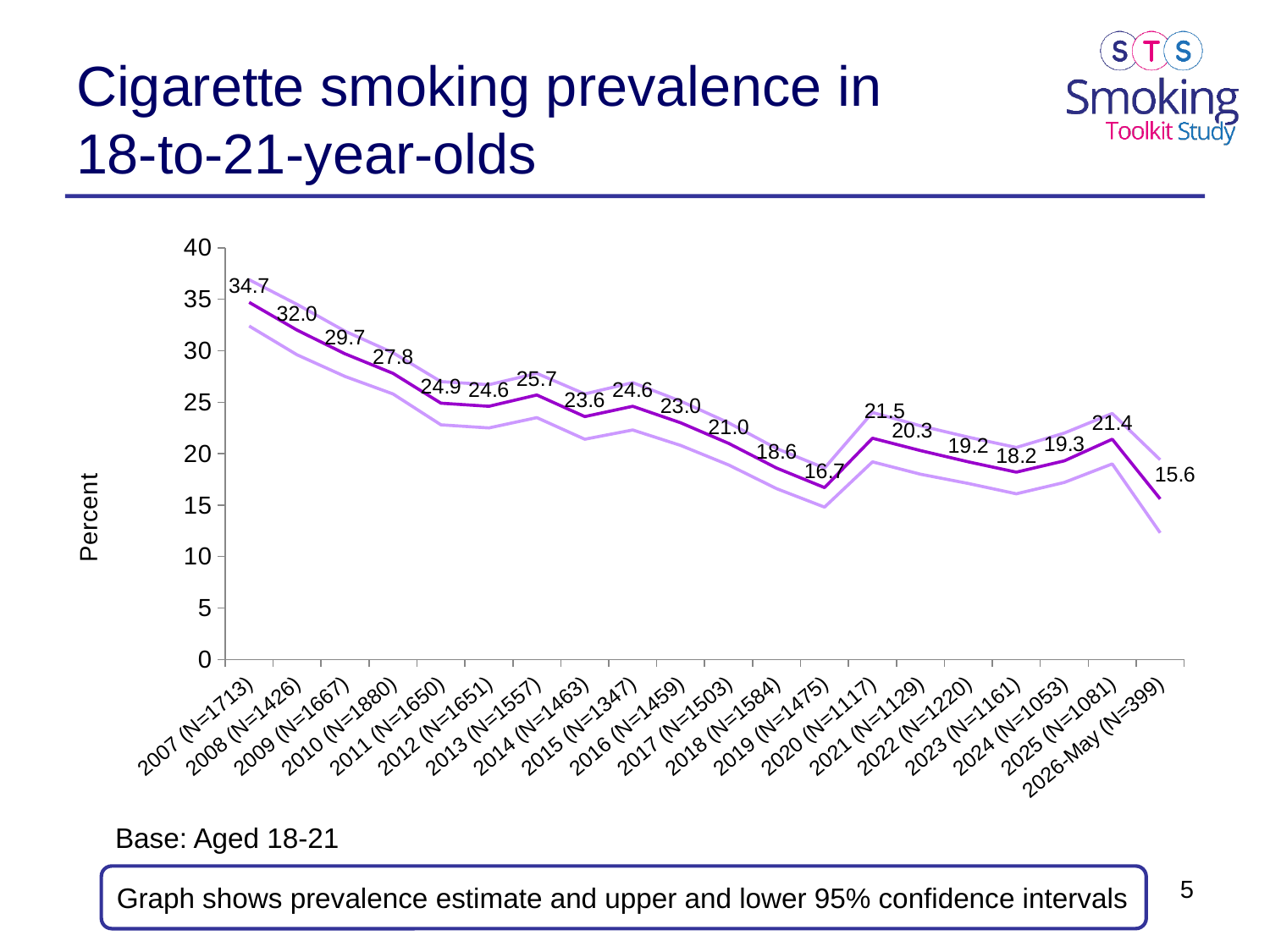
Which is larger, the prevalence estimate for 2013 or for 2014? 2013 What is the cigarette smoking prevalence estimate for 2007 (N=1713)? 34.7 What is the prevalence estimate for 2019 (N=1475)? 16.7 What is the prevalence estimate for 2020 (N=1117)? 21.5 Which year has the lowest prevalence estimate? 2026-May (N=399) Is the prevalence estimate for 2010 greater or less than 25? greater How many time points are plotted on the chart? 20 What kind of chart is shown on the slide? Line chart What is the prevalence estimate for 2026-May (N=399)? 15.6 What is the label on the vertical axis of the chart? Percent What is the difference between the prevalence estimates for 2007 and 2026-May? 19.1 Which year has the highest prevalence estimate? 2007 (N=1713)